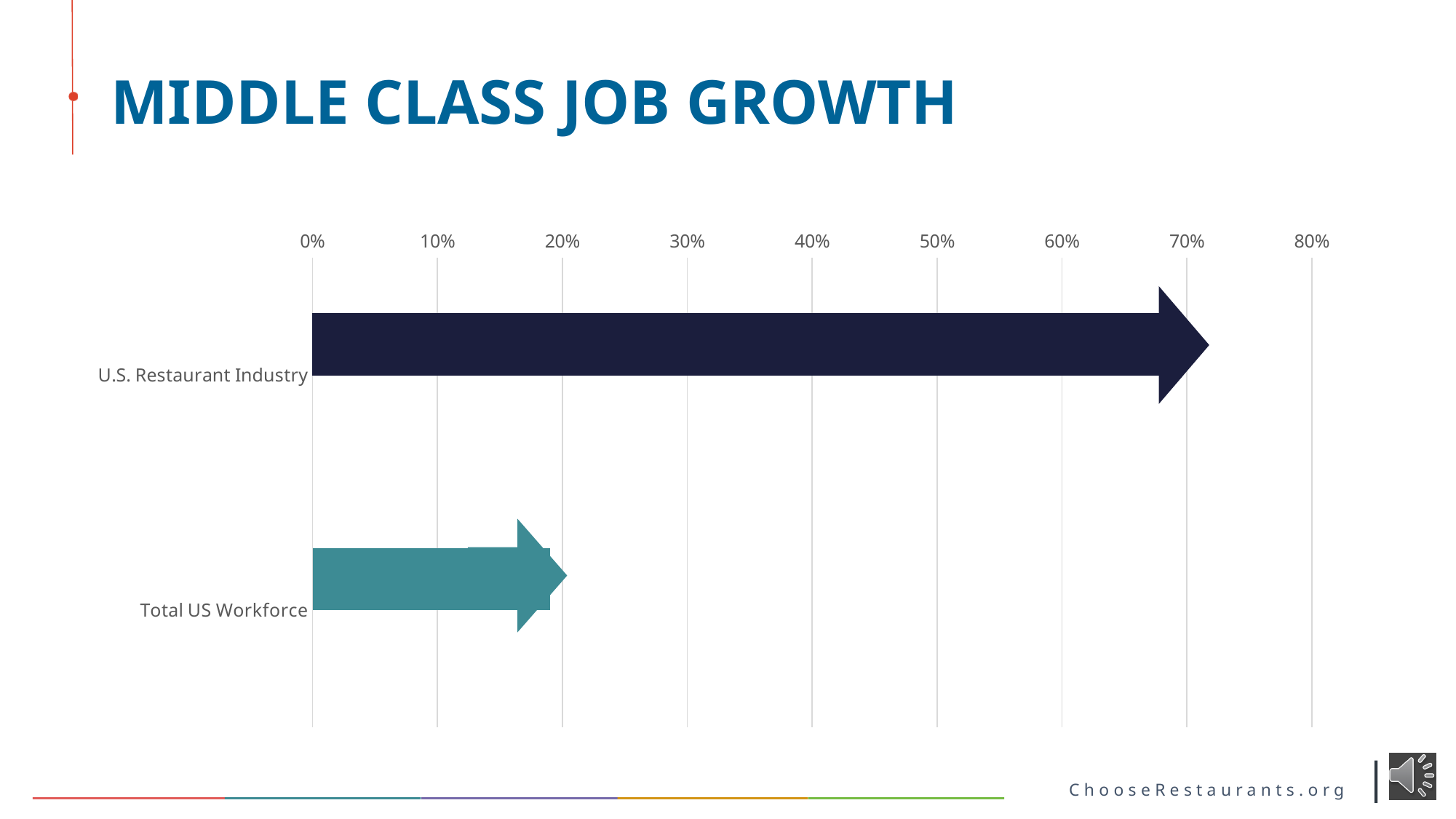
Is the value for U.S. Restaurant Industry greater or less than 80%? less What kind of chart is shown on the slide? bar chart What is the title of the slide containing the chart? MIDDLE CLASS JOB GROWTH Which category has the highest value on the chart? U.S. Restaurant Industry Is the value for U.S. Restaurant Industry greater or less than 60%? greater Is the value for Total US Workforce greater or less than 10%? greater Which is larger, the value for U.S. Restaurant Industry or the value for Total US Workforce? U.S. Restaurant Industry How many categories are plotted on the chart? 2 What is the highest value shown on the chart's horizontal axis? 80% Which category has the lowest value on the chart? Total US Workforce